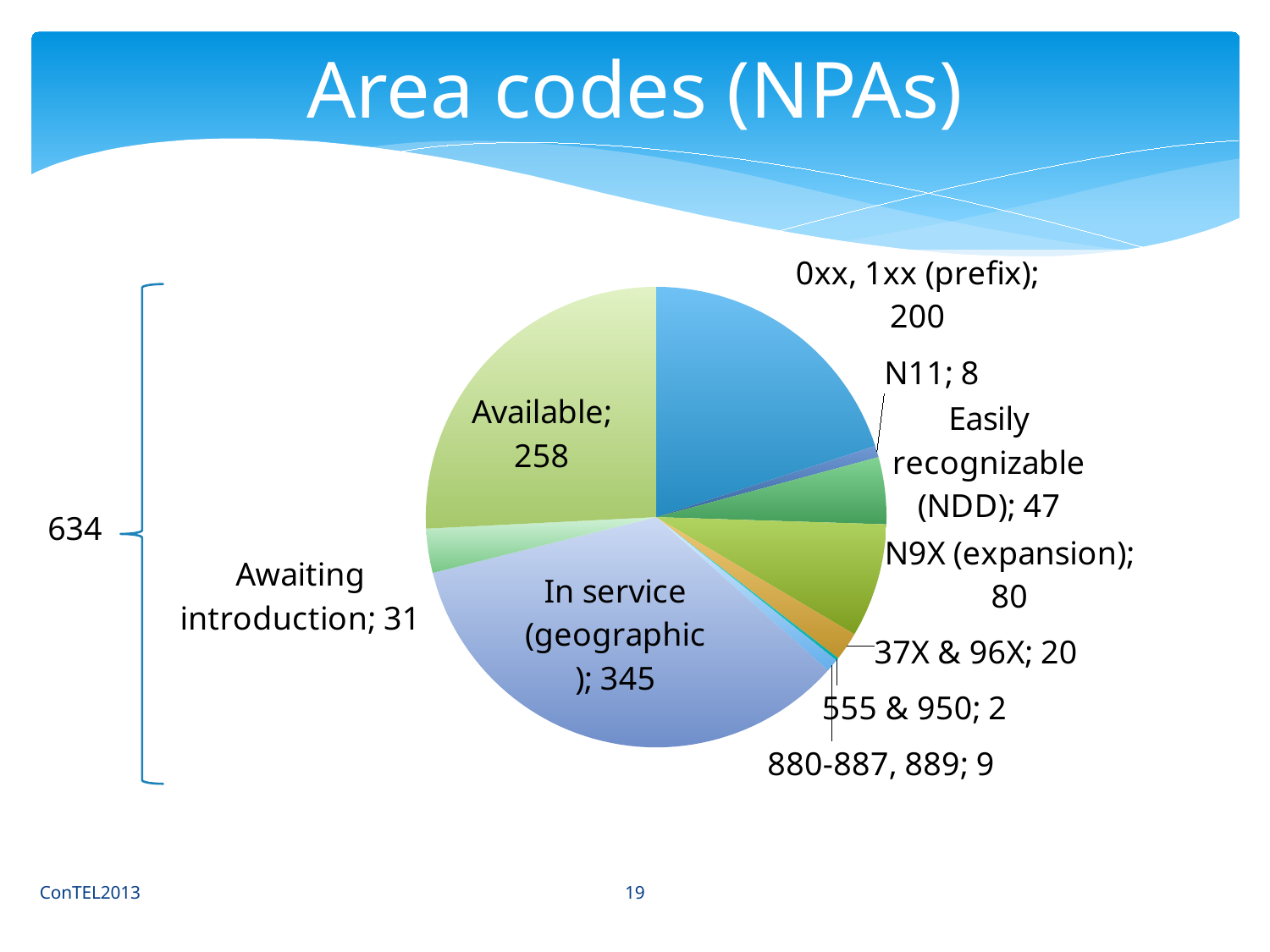
Which category has the smallest slice of the pie? 555 & 950 What is the value for "Available"? 258 What kind of chart is shown on the slide? Pie chart Which is larger, the value for "0xx, 1xx (prefix)" or the value for "N9X (expansion)"? 0xx, 1xx (prefix) Which category has the largest slice of the pie? In service (geographic) What is the difference between the values for "In service (geographic)" and "Available"? 87 What is the value for "Easily recognizable (NDD)"? 47 What is the value for "In service (geographic)"? 345 How many slices does the pie chart have? 10 What share of the pie does "In service (geographic)" represent? 34.5% What is the title of the slide containing the pie chart? Area codes (NPAs) What is the value for "N9X (expansion)"? 80